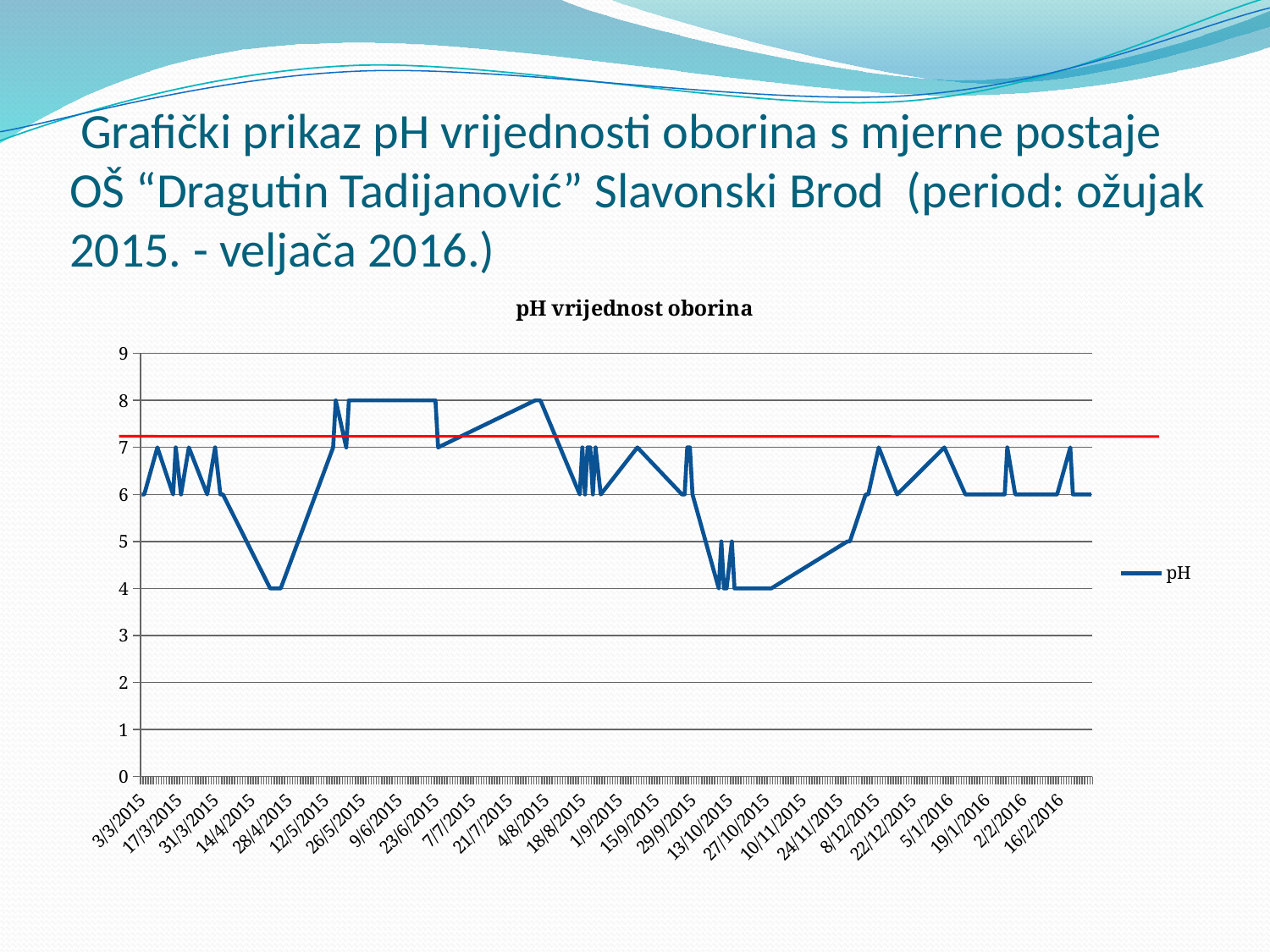
What is the highest pH value reached by the line? 8 What is the lowest pH value reached by the line? 4 Is the pH value on 4/8/2015 greater or less than 7? greater How many series does the legend list? 1 What is the highest value shown on the vertical axis? 9 What kind of chart is shown on the slide? line chart Is the pH value on 9/6/2015 greater or less than 7? greater Is the pH value on 28/4/2015 greater or less than 5? less What is the name of the series shown in the legend? pH What is the title of the chart? pH vrijednost oborina